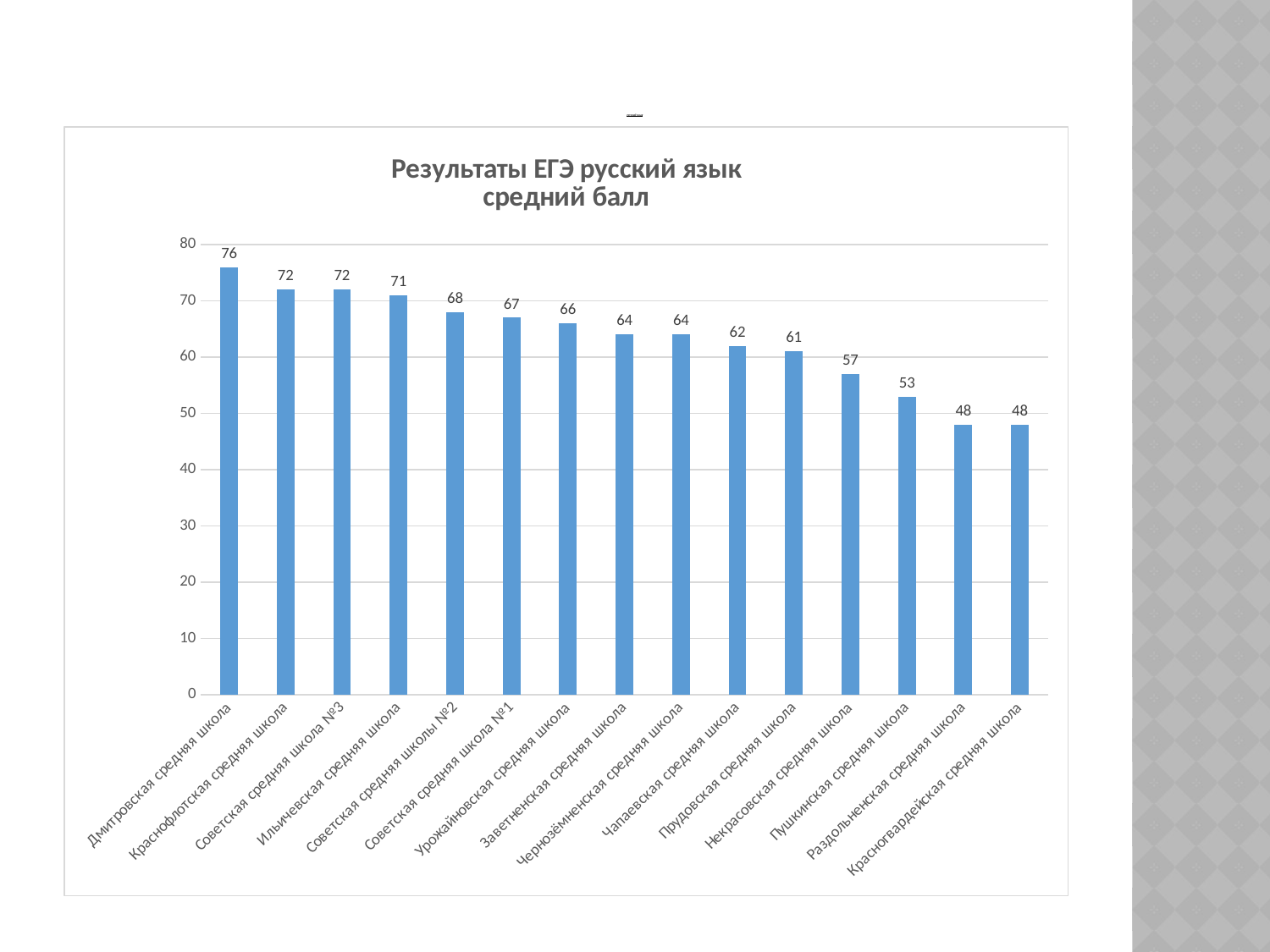
Do the values rise or fall from left to right along the x axis? Fall What is the average score for Дмитровская средняя школа? 76 What is the average score for Пушкинская средняя школа? 53 What type of chart is shown on the slide? Bar chart What is the difference between the average scores of Ильичевская средняя школа and Чапаевская средняя школа? 9 What is the average score for Некрасовская средняя школа? 57 What is the difference between the average scores of Дмитровская средняя школа and Красногвардейская средняя школа? 28 Which has a higher average score, Прудовская средняя школа or Раздольненская средняя школа? Прудовская средняя школа How many schools are shown on the chart? 15 What is the lowest average score shown on the chart? 48 Which school has the highest average score? Дмитровская средняя школа What is the average score for Урожайновская средняя школа? 66